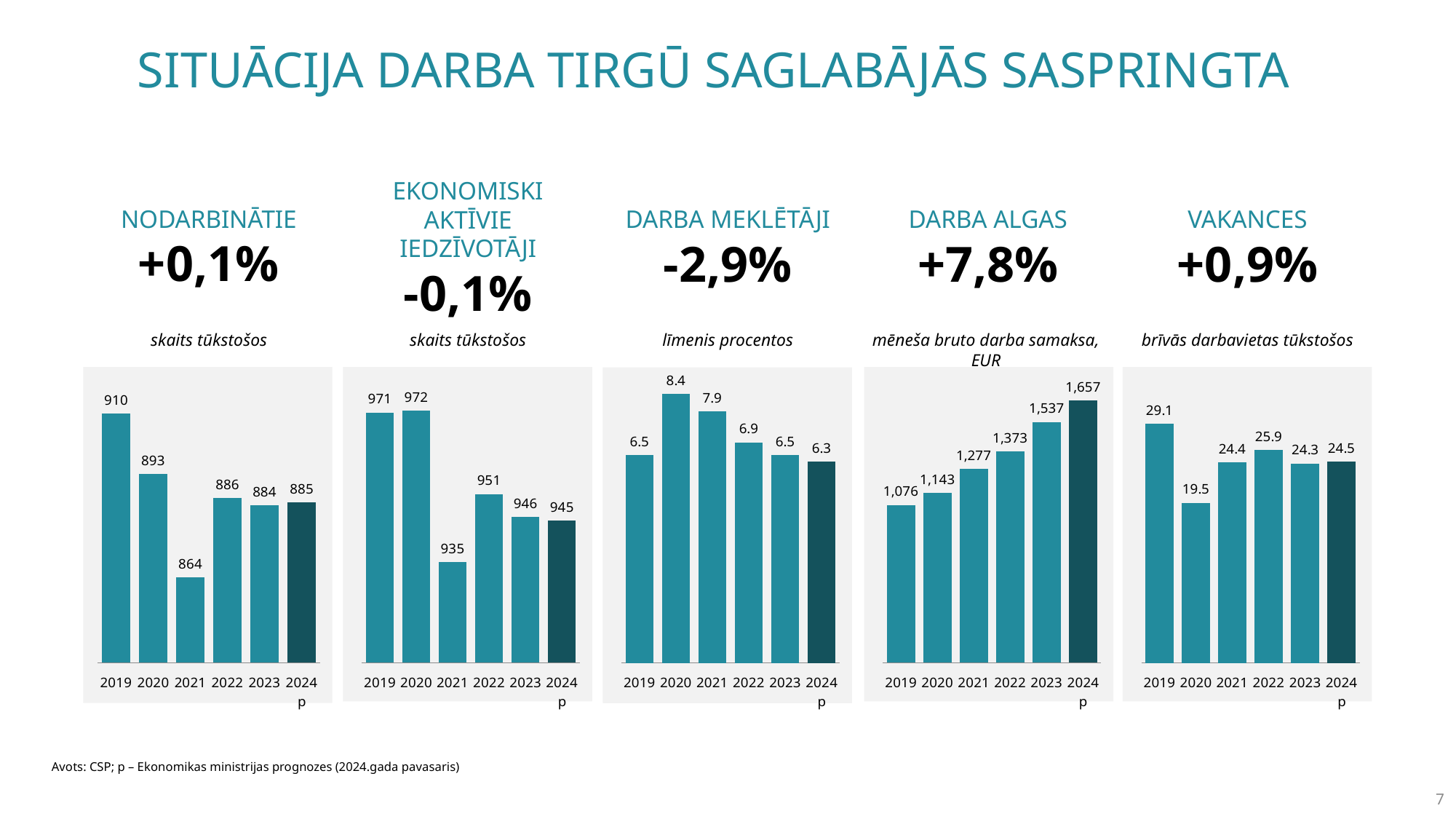
In the NODARBINĀTIE chart, what is the value for 2021? 864 In the NODARBINĀTIE chart, which year has the highest value? 2019 In the DARBA ALGAS chart, what is the value for 2023? 1,537 In the DARBA MEKLĒTĀJI chart, what is the value for 2020? 8.4 In the EKONOMISKI AKTĪVIE IEDZĪVOTĀJI chart, what is the value for 2024 p? 945 In the VAKANCES chart, is the value for 2019 or 2022 larger? 2019 In the DARBA ALGAS chart, do the values rise or fall from 2019 to 2024 p? rise In the VAKANCES chart, which year has the lowest value? 2020 What type of chart is the VAKANCES chart? bar chart How many bars are in the DARBA ALGAS chart? 6 In the DARBA MEKLĒTĀJI chart, what is the difference between the 2020 and 2024 p values? 2.1 In the EKONOMISKI AKTĪVIE IEDZĪVOTĀJI chart, which year has the lowest value? 2021